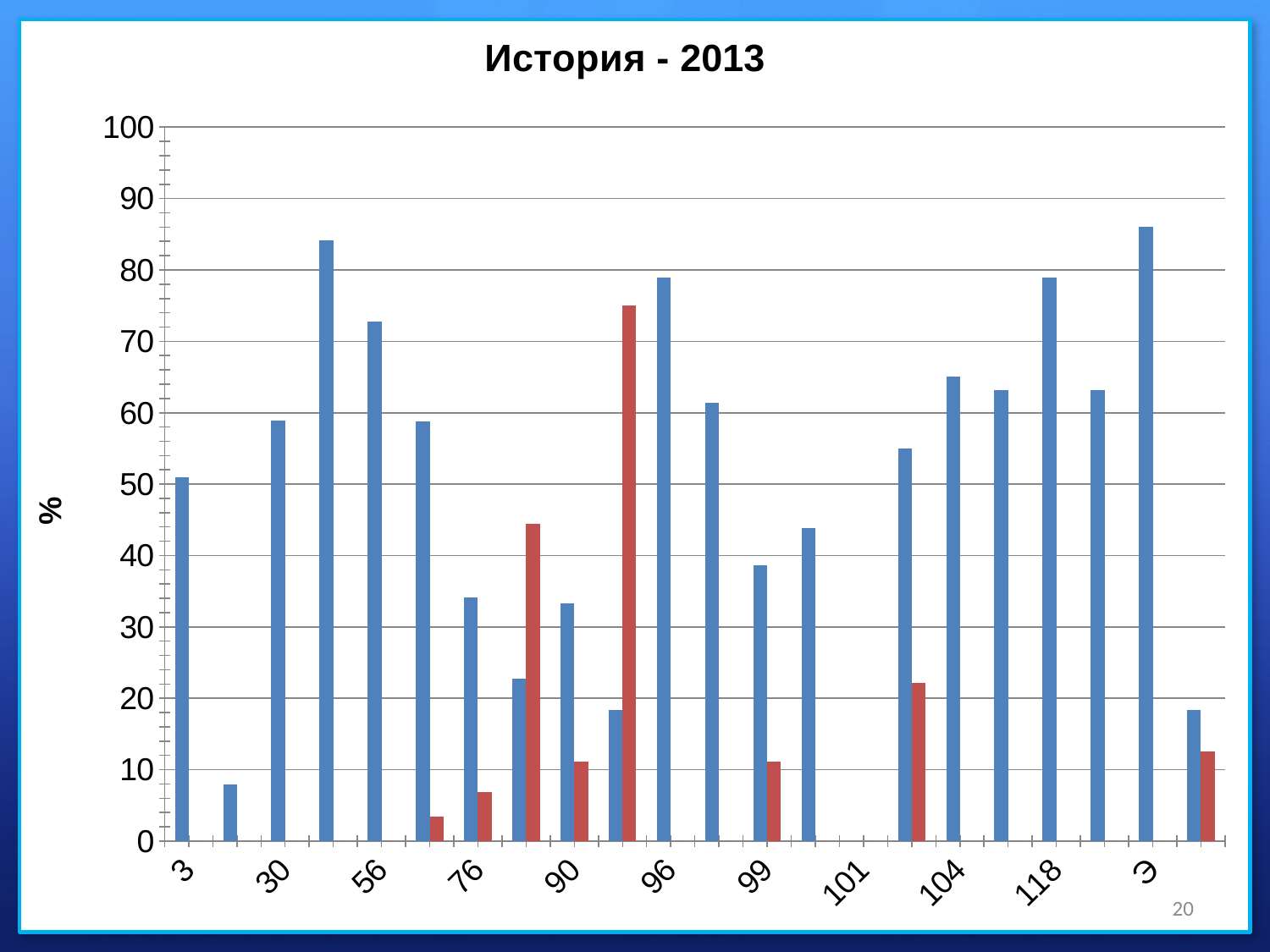
Which has the taller blue bar, category 96 or category 99? 96 What kind of chart is shown on the slide? bar chart Is the value of the blue bar for category 118 greater or less than 70? greater What is the label on the vertical axis of the chart? % Which has the taller blue bar, category 30 or category 76? 30 What is the title of the chart? История - 2013 Is the value of the blue bar for category 90 greater or less than 40? less Is the value of the blue bar for category 96 greater or less than 70? greater